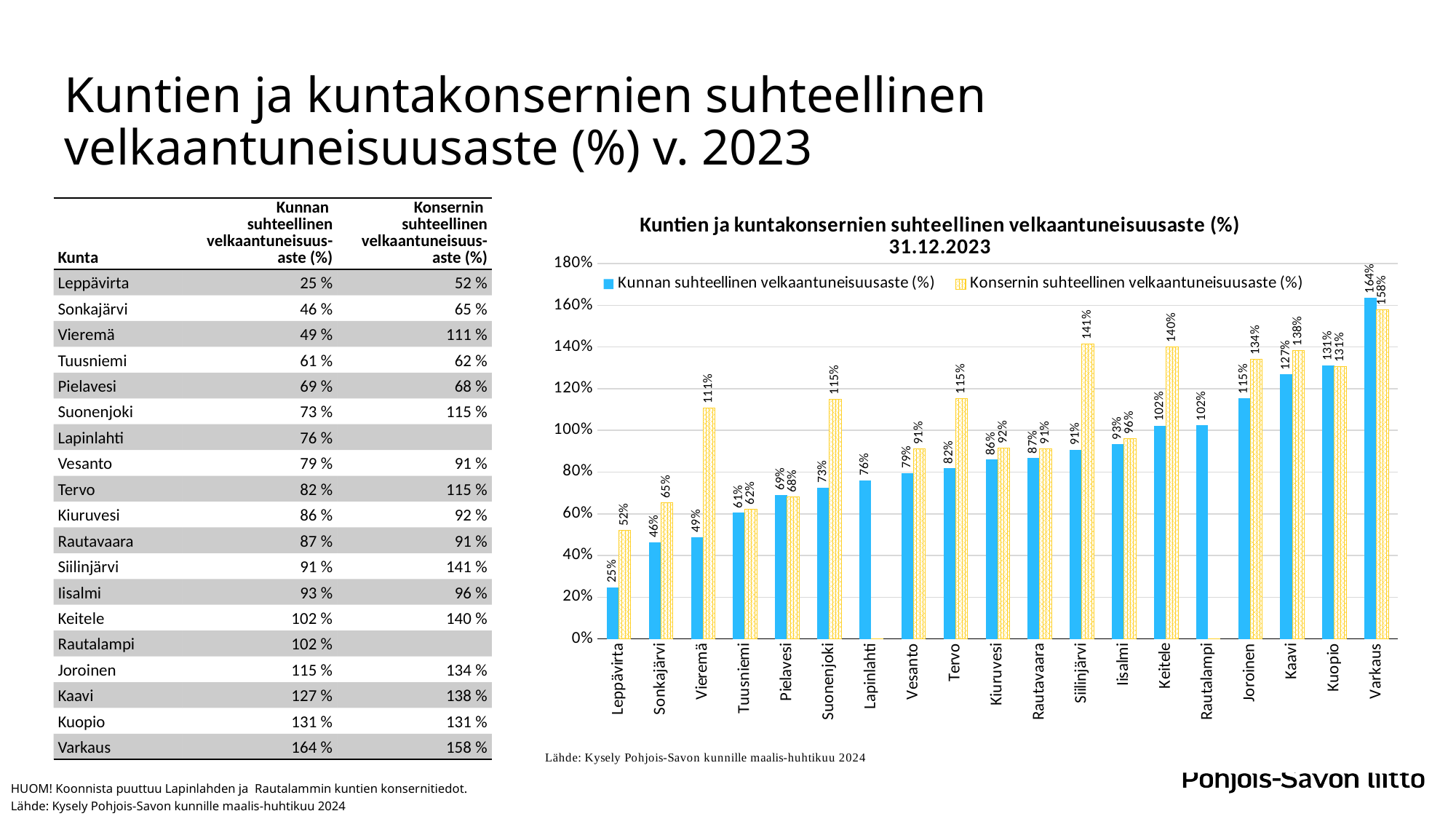
Do the Kunnan suhteellinen velkaantuneisuusaste values generally rise or fall from left to right along the x axis? Rise Is the Konsernin suhteellinen velkaantuneisuusaste value for Joroinen greater or less than 120%? greater How many series does the chart legend list? 2 Which is larger for Pielavesi: the Kunnan or the Konsernin suhteellinen velkaantuneisuusaste? Kunnan suhteellinen velkaantuneisuusaste Which municipality has the highest Kunnan suhteellinen velkaantuneisuusaste (%)? Varkaus Which municipality has the lowest Kunnan suhteellinen velkaantuneisuusaste (%)? Leppävirta What kind of chart is shown on the slide? Bar chart How many municipalities are shown on the x axis of the chart? 19 What is the Konsernin suhteellinen velkaantuneisuusaste (%) value for Vieremä? 111% What date is shown in the chart title? 31.12.2023 What is the Kunnan suhteellinen velkaantuneisuusaste (%) value for Siilinjärvi? 91% What is the difference between the Konsernin and Kunnan suhteellinen velkaantuneisuusaste values for Keitele? 38%